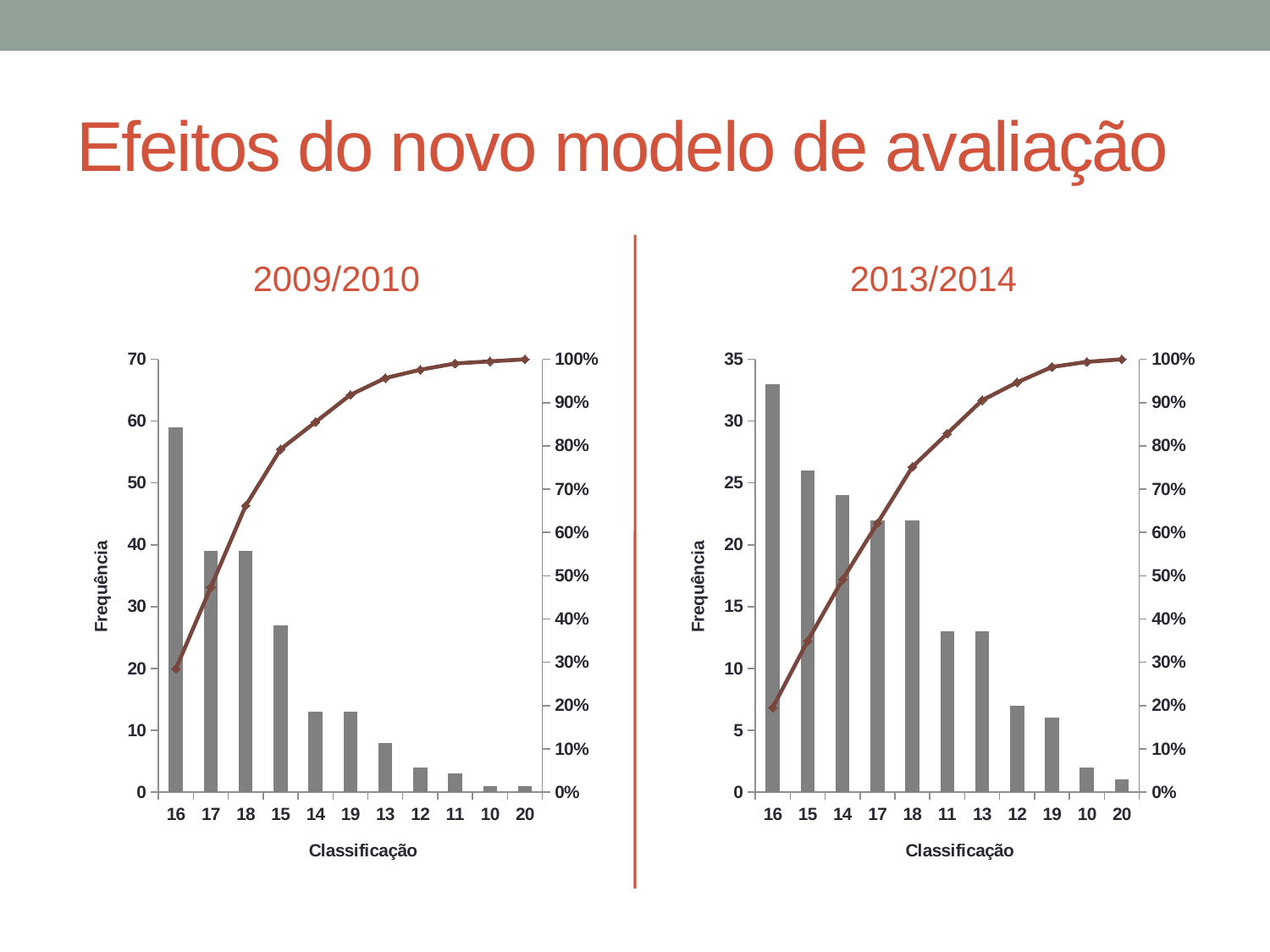
In the 2009/2010 chart, which classification has the highest frequency? 16 In the 2009/2010 chart, is the frequency for classification 13 greater or less than 10? less In the 2013/2014 chart, is the frequency for classification 16 greater or less than 30? greater How many classification categories are shown on the x axis of the 2013/2014 chart? 11 What kind of chart is the 2009/2010 chart? Bar chart with a cumulative percentage line In the 2009/2010 chart, is the frequency for classification 16 greater or less than 50? greater In the 2009/2010 chart, which has the higher frequency, classification 17 or classification 15? 17 In the 2013/2014 chart, which classification has the highest frequency? 16 In the 2013/2014 chart, which has the higher frequency, classification 15 or classification 18? 15 In the 2013/2014 chart, do the bar heights rise or fall from left to right along the x axis? Fall What is the x-axis title of the 2009/2010 chart? Classificação